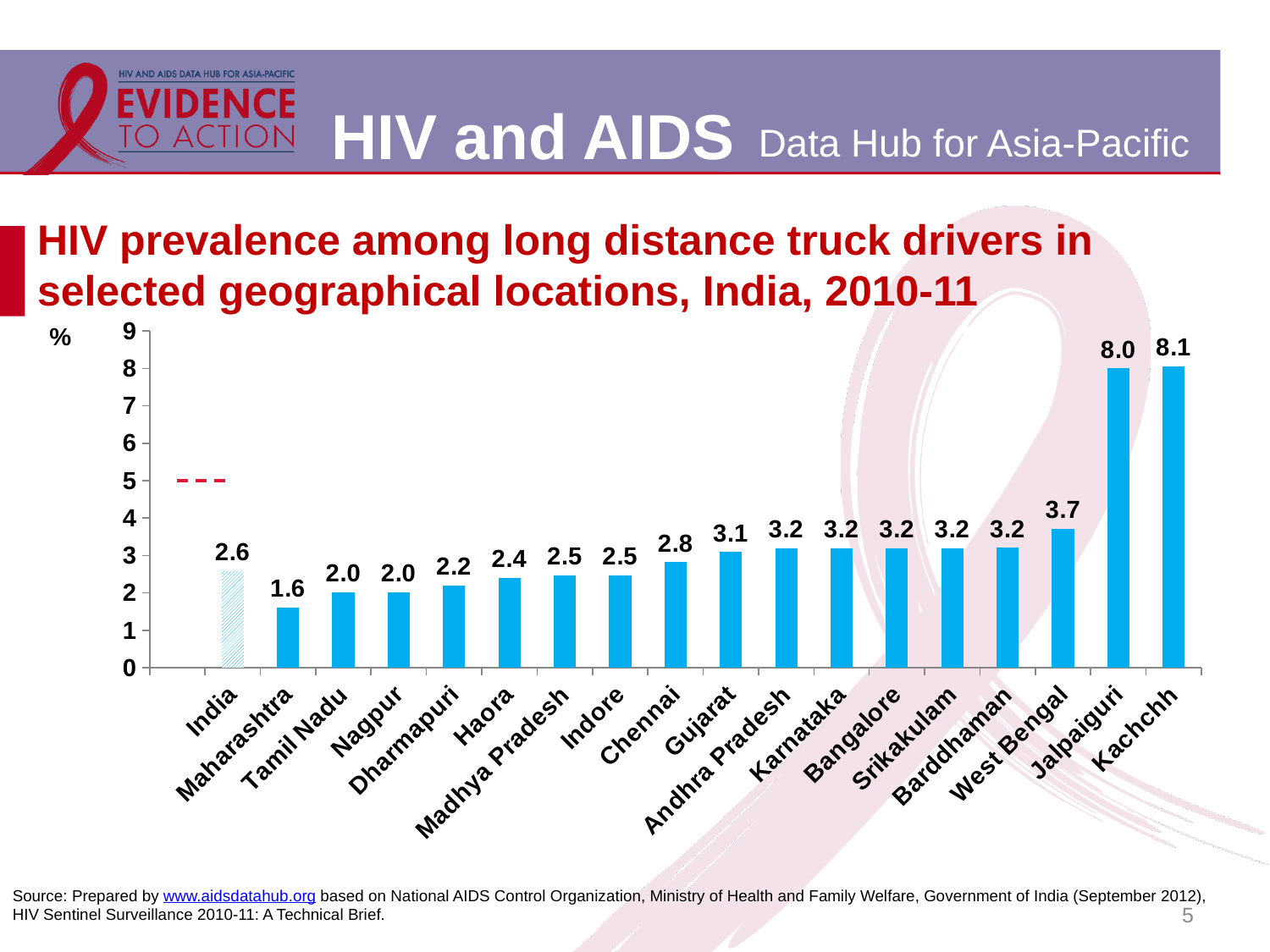
Which location has the highest HIV prevalence in the chart? Kachchh Which location has the lowest HIV prevalence in the chart? Maharashtra What is the value shown for Maharashtra? 1.6 What is the value shown for West Bengal? 3.7 Which has a larger value, Chennai or Haora? Chennai What is the difference between the values for West Bengal and Maharashtra? 2.1 What is the difference between the values for Kachchh and Jalpaiguri? 0.1 What is the value shown for Jalpaiguri? 8.0 How many locations (bars) are shown in the chart? 18 What kind of chart is shown on the slide? Bar chart What unit is indicated on the vertical axis of the chart? % What is the HIV prevalence value shown for India? 2.6